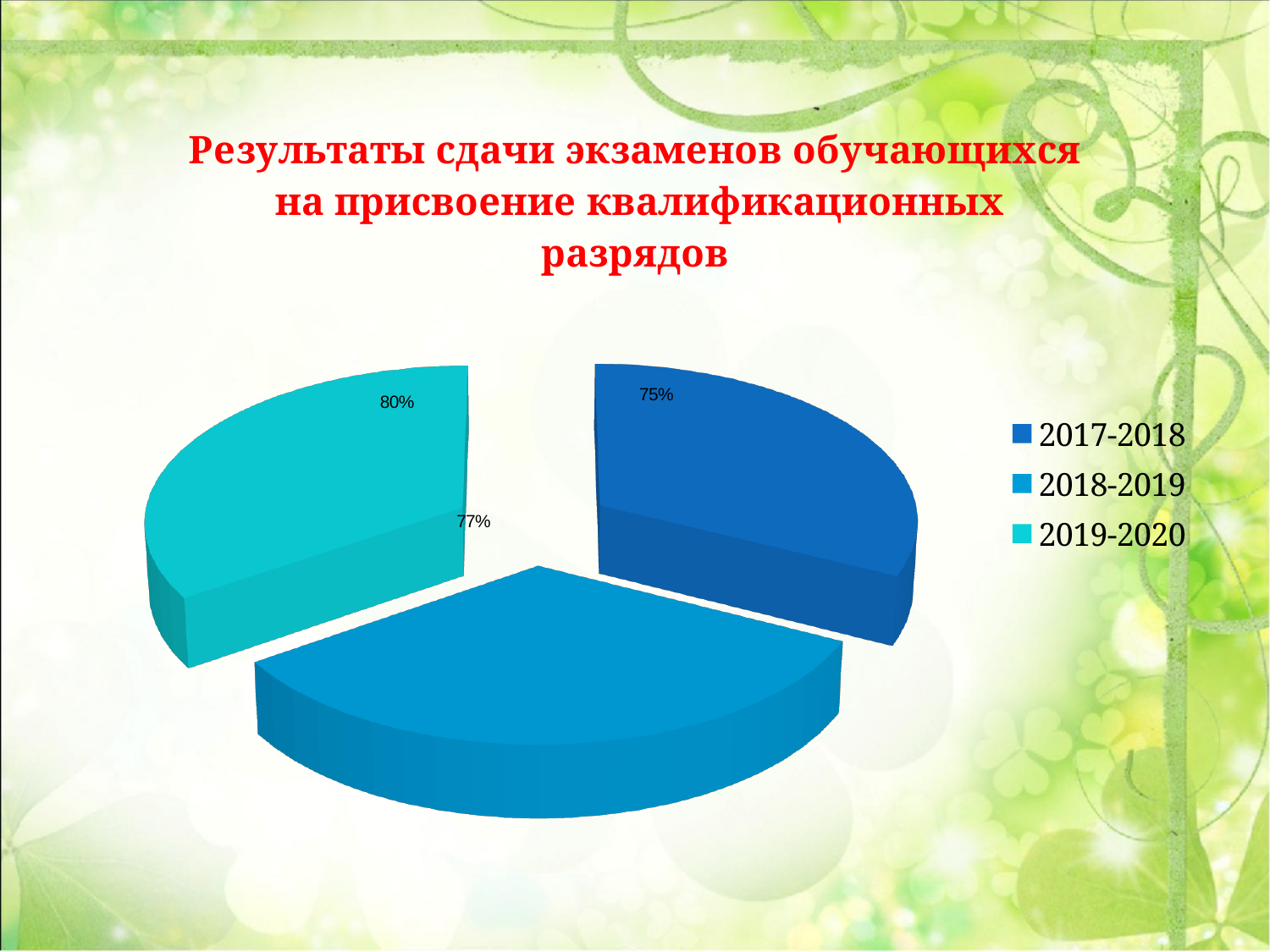
What value is shown for 2018-2019 on the pie chart? 77% What value is shown for 2019-2020 on the pie chart? 80% What is the difference between the values for 2018-2019 and 2017-2018? 2% What type of chart is shown on the slide? Pie chart What is the difference between the values for 2019-2020 and 2017-2018? 5% Do the values rise or fall from 2017-2018 to 2019-2020? Rise What colour is the slice for 2019-2020? Cyan (light blue) How many categories does the pie chart show? 3 Which academic year has the lowest value on the pie chart? 2017-2018 Which has a larger value, 2018-2019 or 2019-2020? 2019-2020 Which academic year has the highest value on the pie chart? 2019-2020 What value is shown for 2017-2018 on the pie chart? 75%